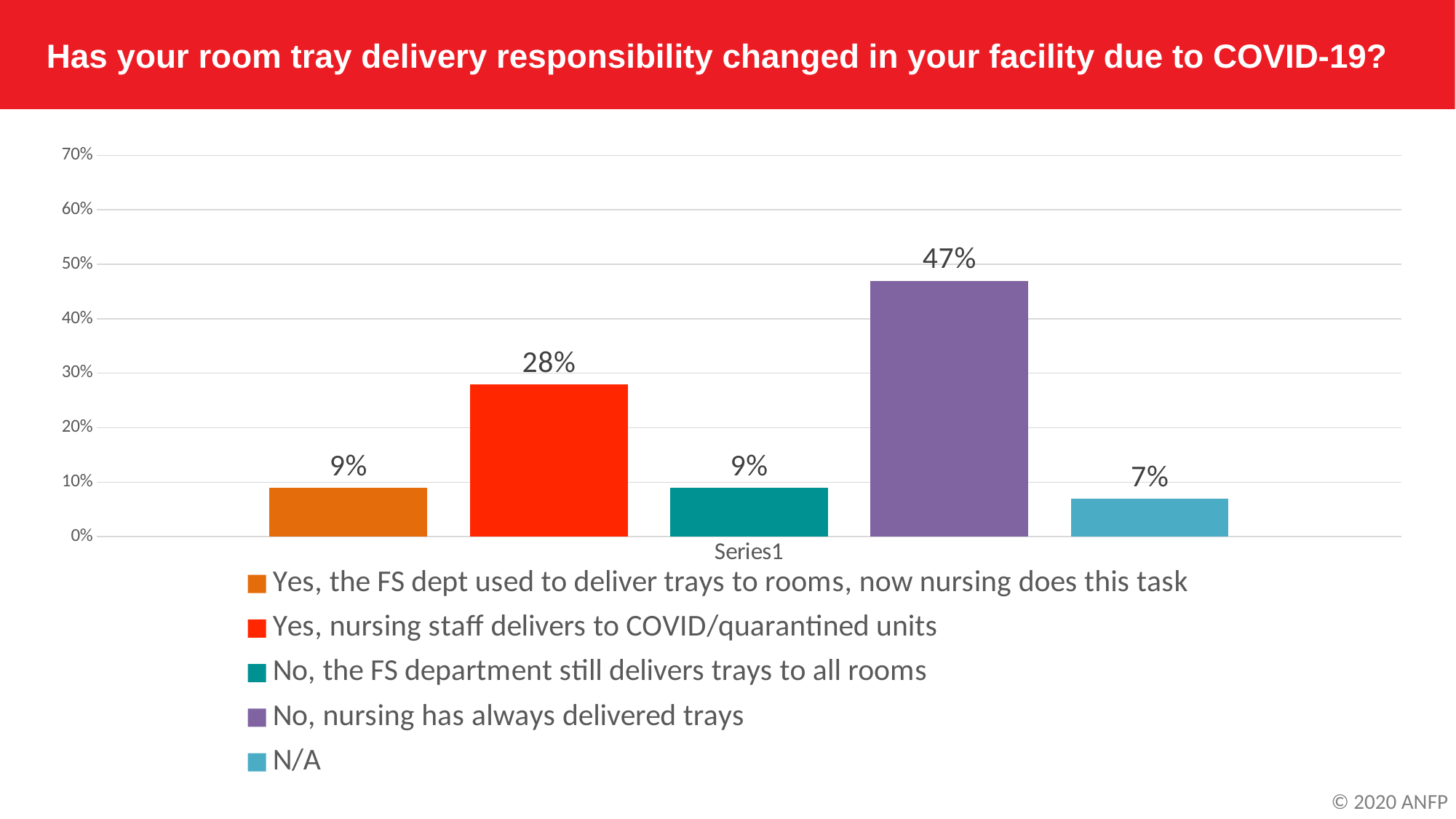
Which response has the highest percentage? No, nursing has always delivered trays What type of chart is shown on the slide? Bar chart What percentage of respondents answered "N/A"? 7% Which response has the lowest percentage? N/A How many entries does the legend list? 5 What percentage of respondents answered "Yes, nursing staff delivers to COVID/quarantined units"? 28% What percentage of respondents answered "No, nursing has always delivered trays"? 47% What colour is the bar for "No, nursing has always delivered trays"? Purple Which is larger: the percentage for "Yes, nursing staff delivers to COVID/quarantined units" or for "Yes, the FS dept used to deliver trays to rooms, now nursing does this task"? Yes, nursing staff delivers to COVID/quarantined units What percentage of respondents answered "No, the FS department still delivers trays to all rooms"? 9% How many response categories are shown in the chart? 5 What is the difference in percentage points between "No, nursing has always delivered trays" and "Yes, nursing staff delivers to COVID/quarantined units"? 19 percentage points